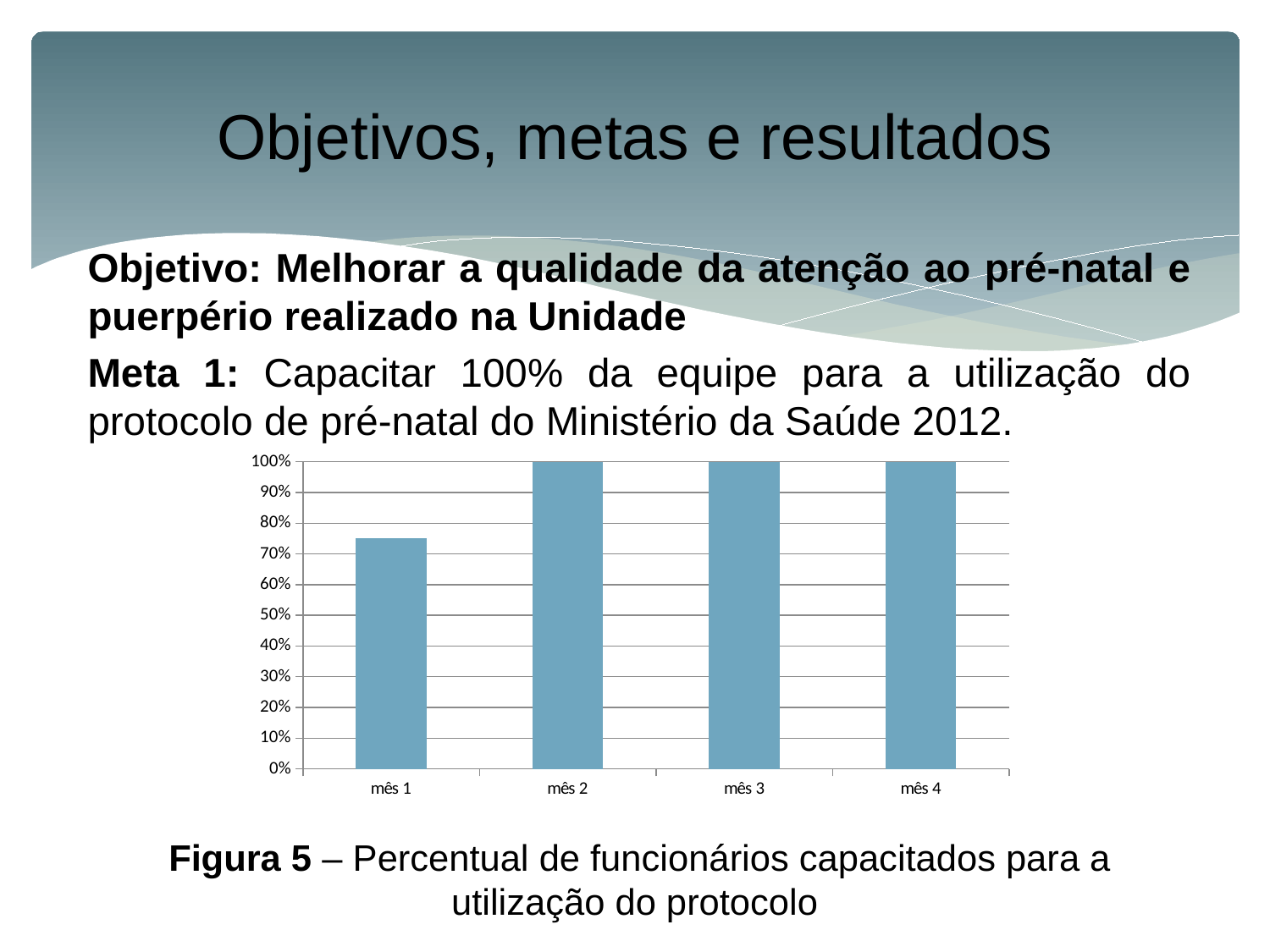
What kind of chart is shown on the slide? bar chart What is the highest value shown on the y axis of the chart? 100% Which month has the lowest value in the chart? mês 1 What is the figure number given in the caption below the chart? Figura 5 Which is larger, the value for mês 1 or the value for mês 2? mês 2 Is the value for mês 1 greater or less than 80%? less What is the value for mês 4 in the chart? 100% What is the value for mês 2 in the chart? 100% Do the values rise or fall from mês 1 to mês 2? rise Is the value for mês 1 greater or less than 70%? greater What is the value for mês 3 in the chart? 100% How many categories (months) are shown on the x axis of the chart? 4